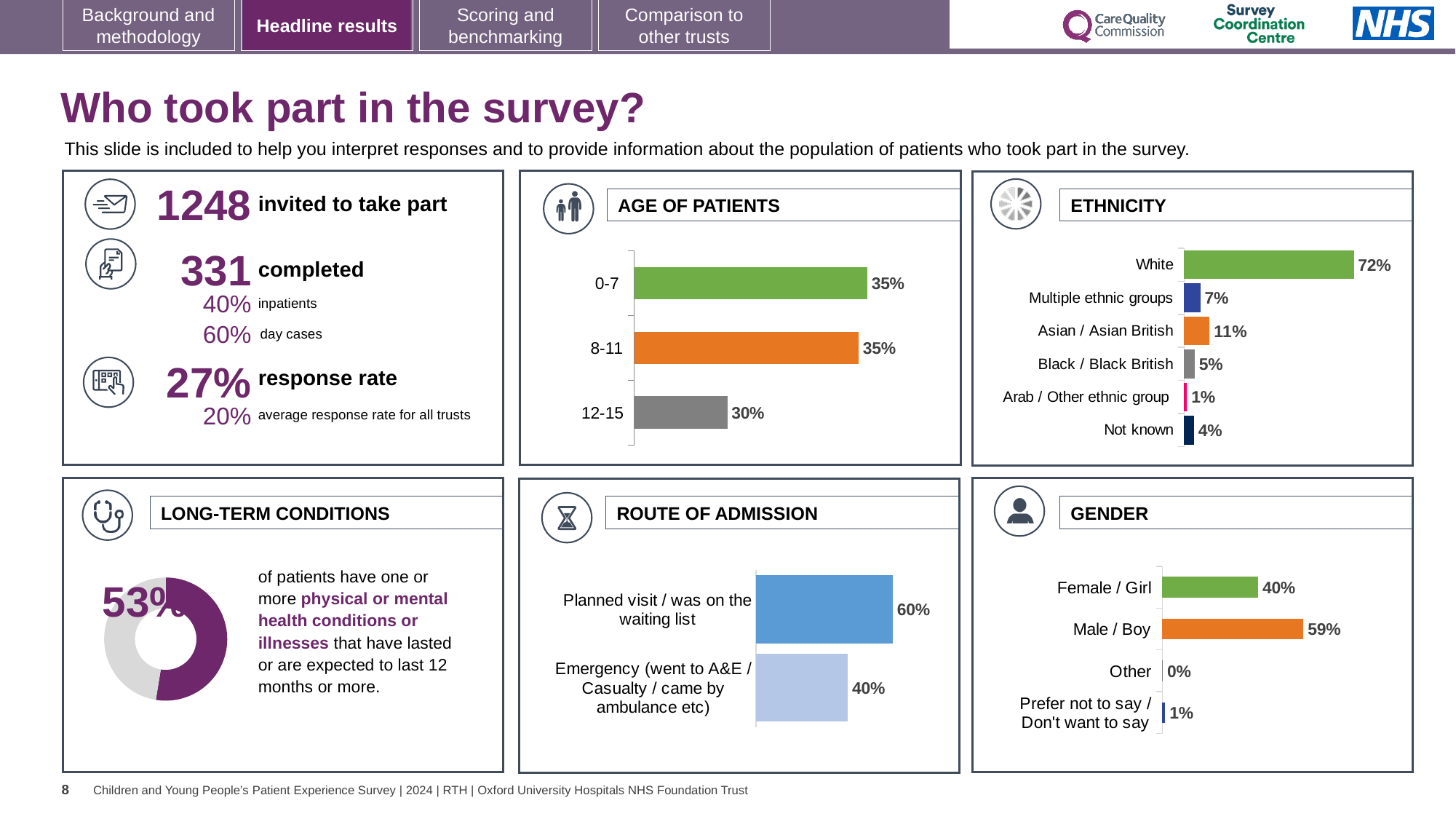
In the AGE OF PATIENTS chart, how many age categories are shown? 3 In the ETHNICITY chart, which category has the lowest value? Arab / Other ethnic group In the ETHNICITY chart, what is the difference between the values for White and Multiple ethnic groups? 65% In the ETHNICITY chart, how many categories are shown? 6 In the AGE OF PATIENTS chart, what is the value for the 12-15 age group? 30% In the ROUTE OF ADMISSION chart, which is larger: Planned visit / was on the waiting list or Emergency? Planned visit / was on the waiting list In the GENDER chart, what is the value for Male / Boy? 59% In the ETHNICITY chart, what is the value for Asian / Asian British? 11% In the GENDER chart, what is the difference between the values for Male / Boy and Female / Girl? 19% In the ROUTE OF ADMISSION chart, what is the value for Emergency (went to A&E / Casualty / came by ambulance etc)? 40% What kind of chart is used in the LONG-TERM CONDITIONS panel? Doughnut chart In the ETHNICITY chart, which category has the highest value? White